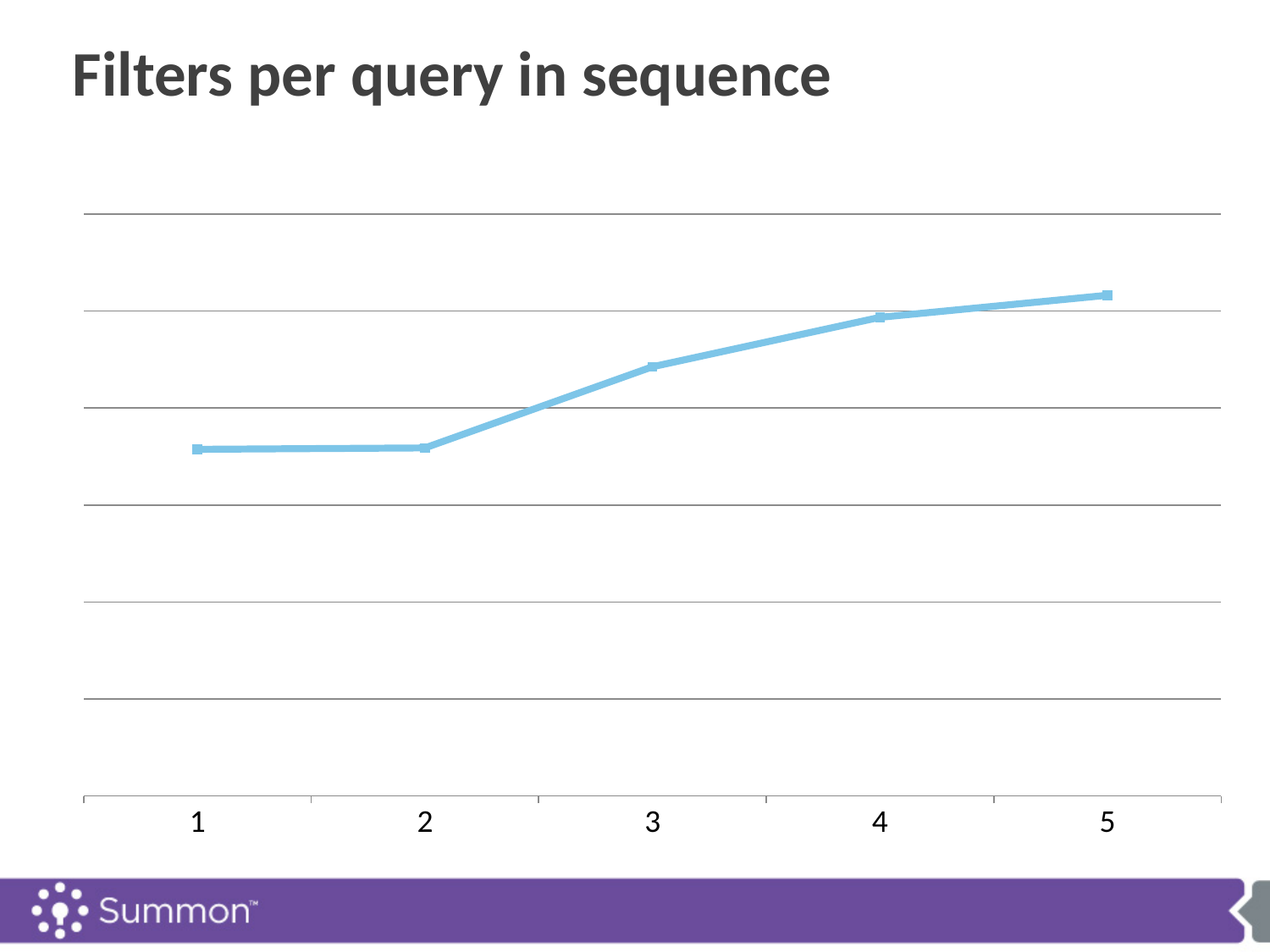
What is the title of the chart? Filters per query in sequence Do the values generally rise or fall from 1 to 5 along the x axis? rise Which has the larger value, category 2 or category 3? 3 Which has the larger value, category 3 or category 4? 4 Which x-axis category has the highest value? 5 Which has the larger value, category 1 or category 5? 5 What colour is the plotted line? light blue What kind of chart is shown on the slide? line chart Between which two consecutive categories does the line rise the most? 2 and 3 How many points are plotted along the x axis? 5